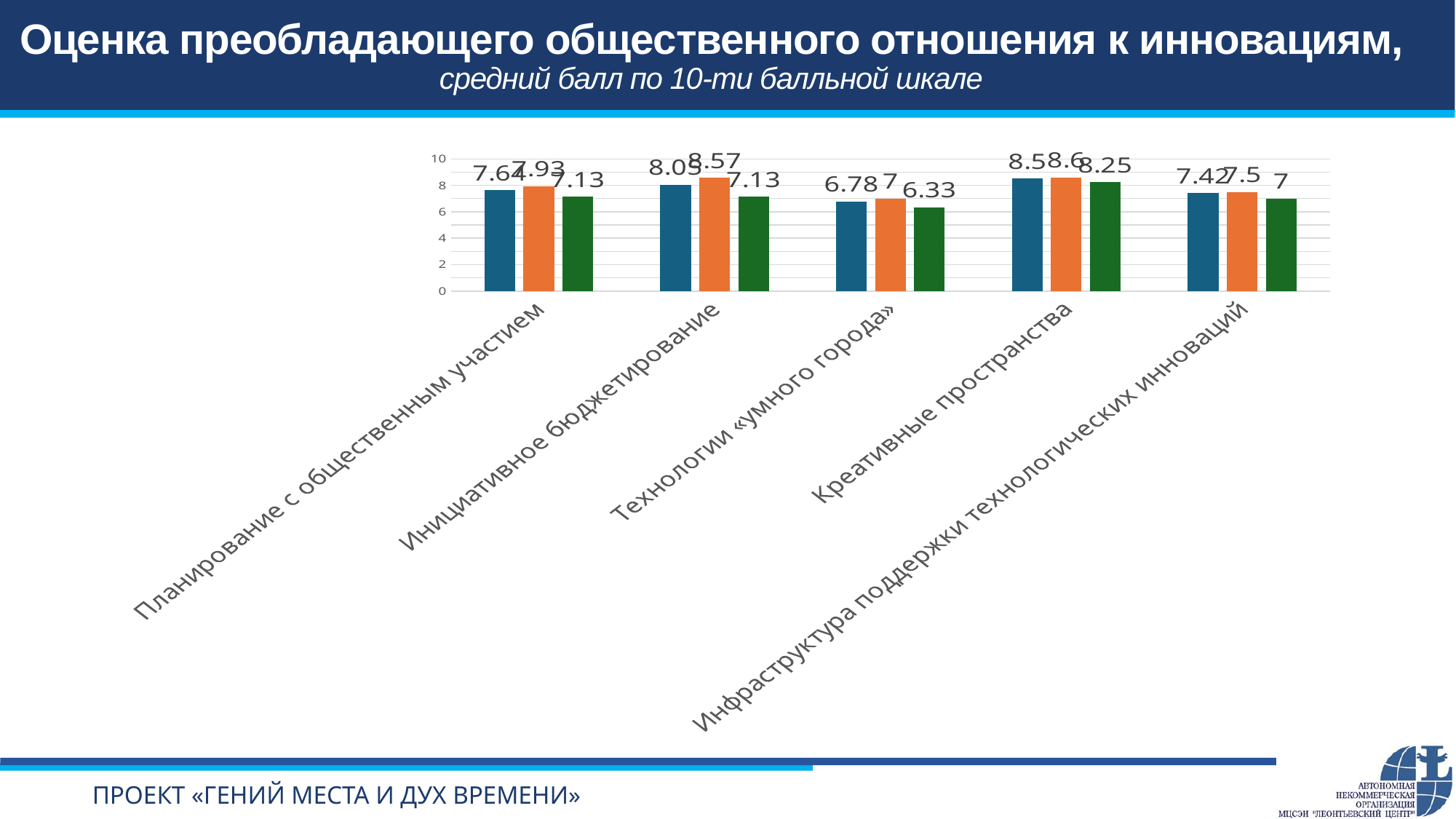
What is the value of the blue bar for «Планирование с общественным участием»? 7.64 Which category has the highest orange bar? Креативные пространства What is the value of the green bar for «Инфраструктура поддержки технологических инноваций»? 7 How many bars are shown for each category in the chart? 3 How many categories are shown along the x axis of the chart? 5 What kind of chart is shown on the slide? bar chart What is the value of the green bar for «Технологии «умного города»»? 6.33 What is the value of the orange bar for «Инициативное бюджетирование»? 8.57 What is the difference between the orange and green bars for «Инициативное бюджетирование»? 1.44 Which is larger for «Технологии «умного города»»: the blue bar or the orange bar? the orange bar What is the maximum value shown on the vertical axis of the chart? 10 Which category has the lowest green bar? Технологии «умного города»